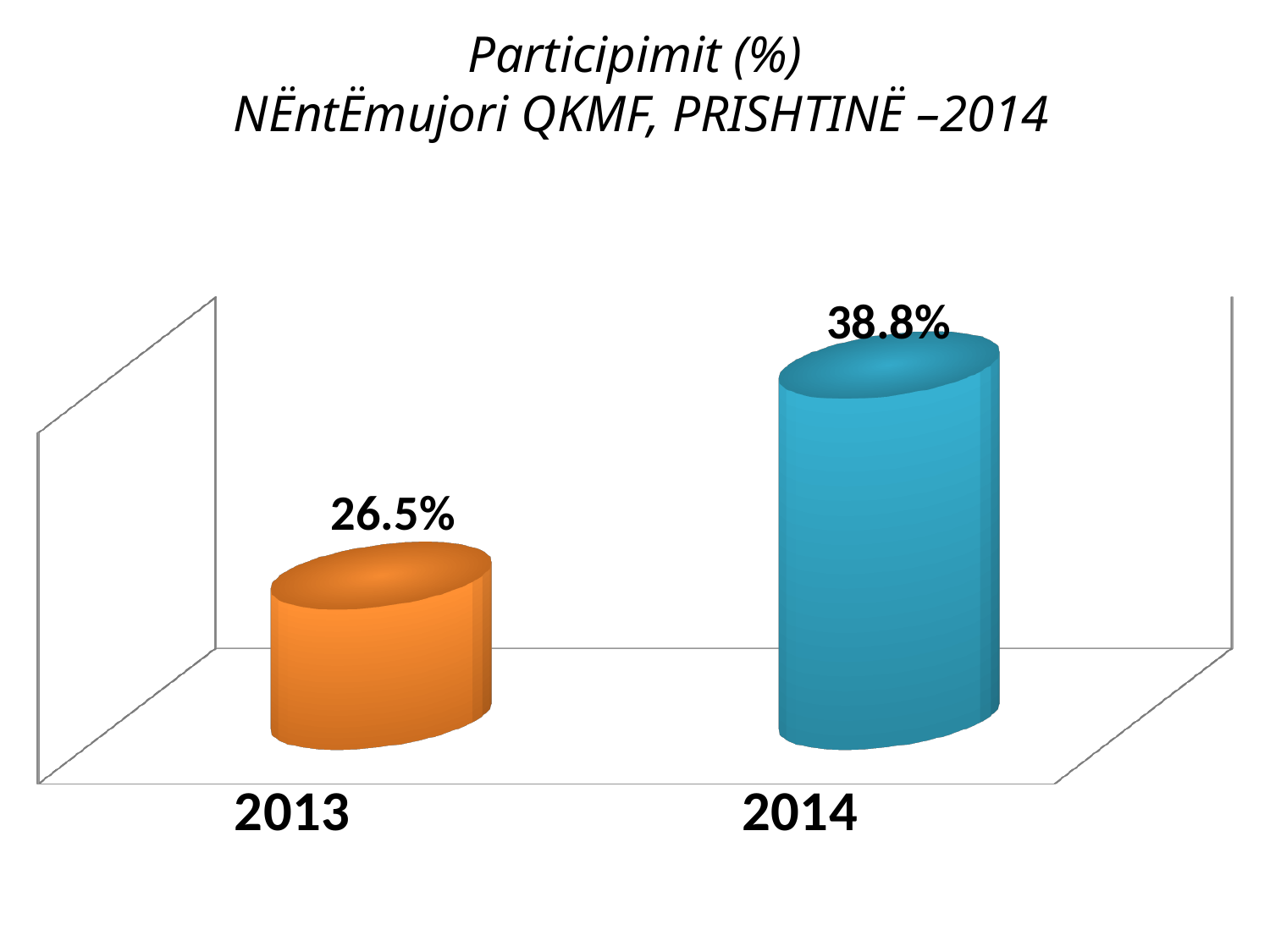
How many categories are shown on the chart? 2 What kind of chart is this? bar chart What colour is the bar for 2014? blue What is the difference between the values for 2014 and 2013? 12.3% Which year has the lowest value? 2013 What colour is the bar for 2013? orange Do the values rise or fall from 2013 to 2014? rise Which is larger, the value for 2013 or the value for 2014? 2014 Which year has the highest value? 2014 What is the value for 2013? 26.5% What is the value for 2014? 38.8%